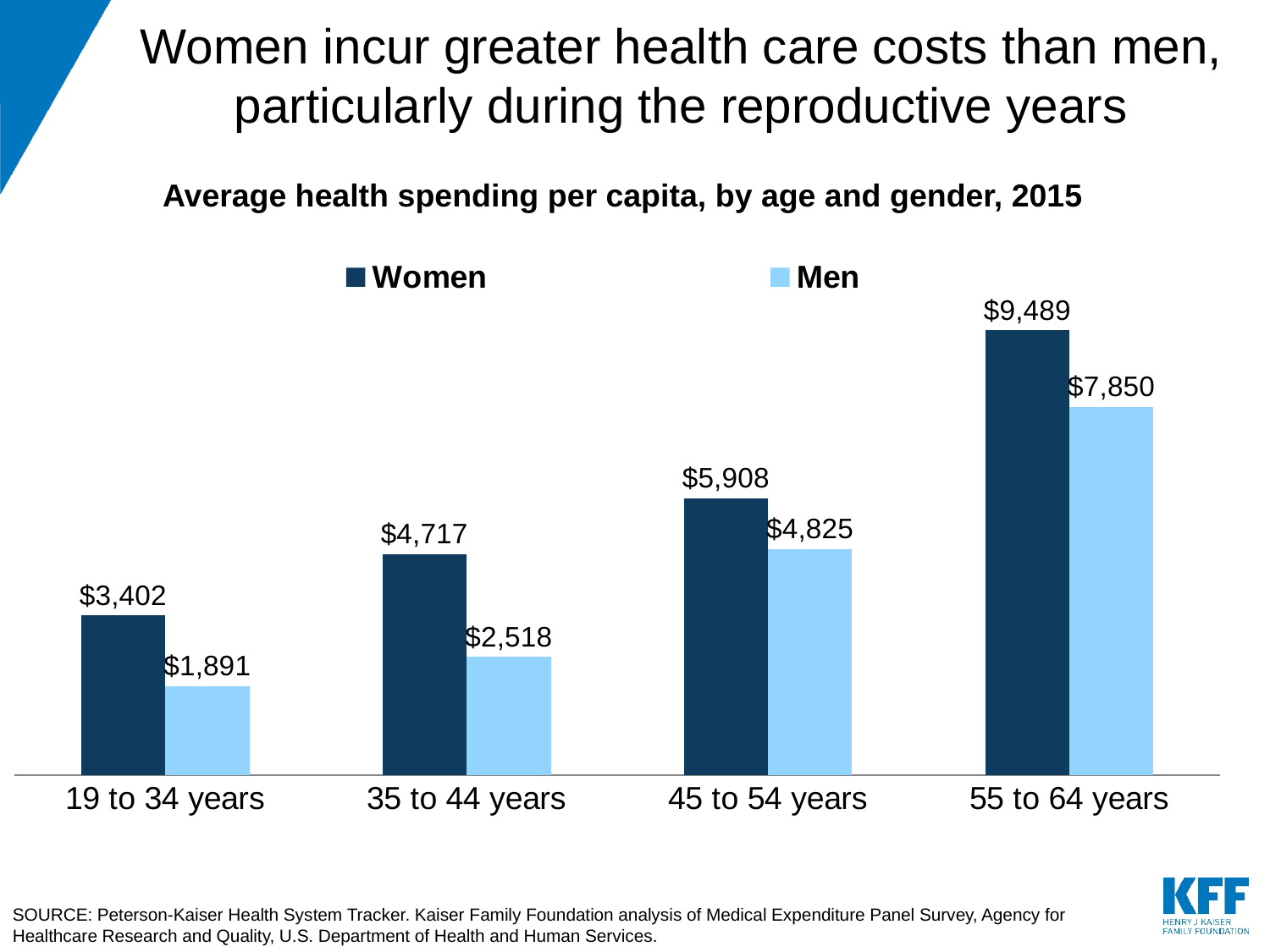
Which is larger: average health spending for women aged 35 to 44 years or for men aged 45 to 54 years? Men aged 45 to 54 years What is the difference between women's and men's average health spending per capita in the 55 to 64 years age group? $1,639 Which age group has the highest average health spending per capita for women? 55 to 64 years What is the average health spending per capita for men aged 45 to 54 years? $4,825 What kind of chart is shown on the slide? Bar chart What is the difference between women's and men's average health spending per capita in the 19 to 34 years age group? $1,511 Which age group has the lowest average health spending per capita for men? 19 to 34 years Do the values for men rise or fall as age increases along the x axis? Rise How many age groups are shown on the chart? 4 What is the average health spending per capita for women aged 19 to 34 years? $3,402 How many series does the legend list? 2 What is the average health spending per capita for men aged 35 to 44 years? $2,518